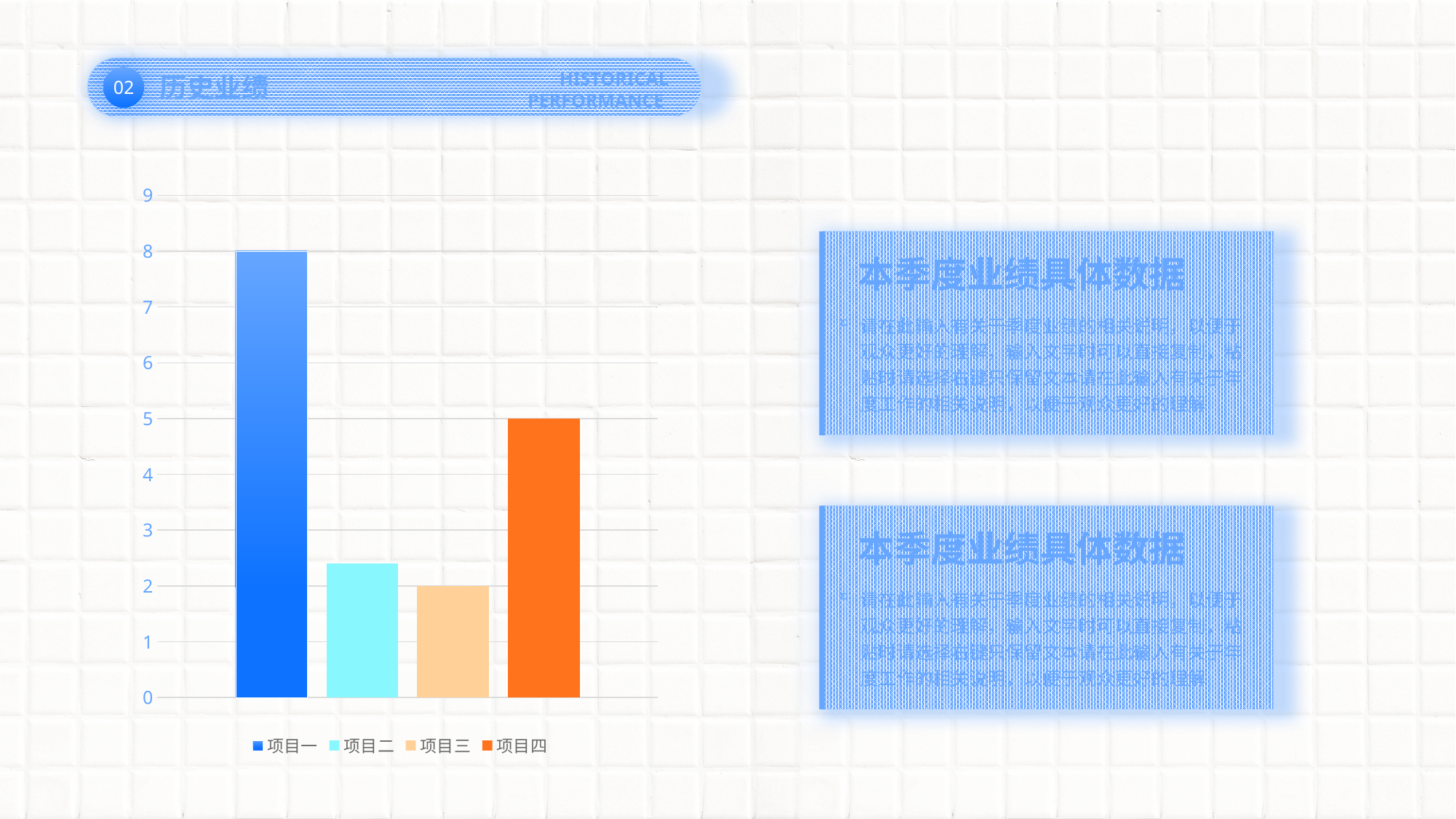
What type of chart is shown on the slide? bar chart What is the difference between the values of 项目一 and 项目四? 3 Which series has the lowest bar in the chart? 项目三 How many series does the chart legend list? 4 Which is larger, the value for 项目四 or the value for 项目二? 项目四 What is the value of the bar for 项目四? 5 How many bars are plotted in the chart? 4 Which series has the highest bar in the chart? 项目一 Is the value for 项目二 greater or less than 3? less What is the value of the bar for 项目一? 8 What colour is the bar for 项目四 in the chart? orange What is the value of the bar for 项目三? 2